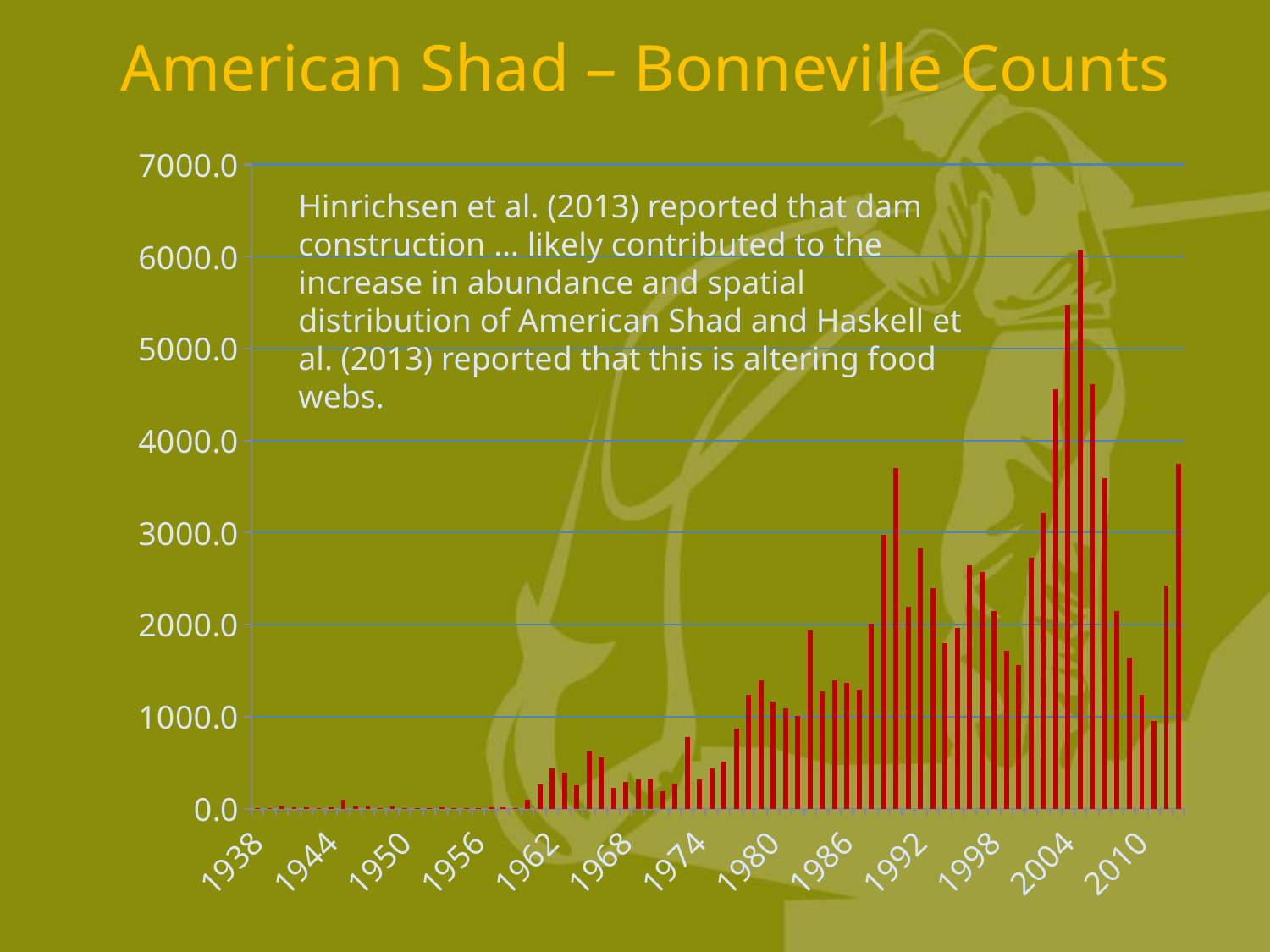
Is the tallest bar on the chart greater or less than 5000? greater What type of chart is shown on the slide? Bar chart What is the highest value shown on the vertical axis? 7000.0 Is the value for 2004 greater or less than 2000? greater What is the title of the chart? American Shad – Bonneville Counts Is the value for 1998 greater or less than 2000? greater Which year has the larger count, 1962 or 1998? 1998 Which year has the larger count, 1938 or 2010? 2010 Do the American Shad counts generally rise or fall from 1938 to 2010? Rise